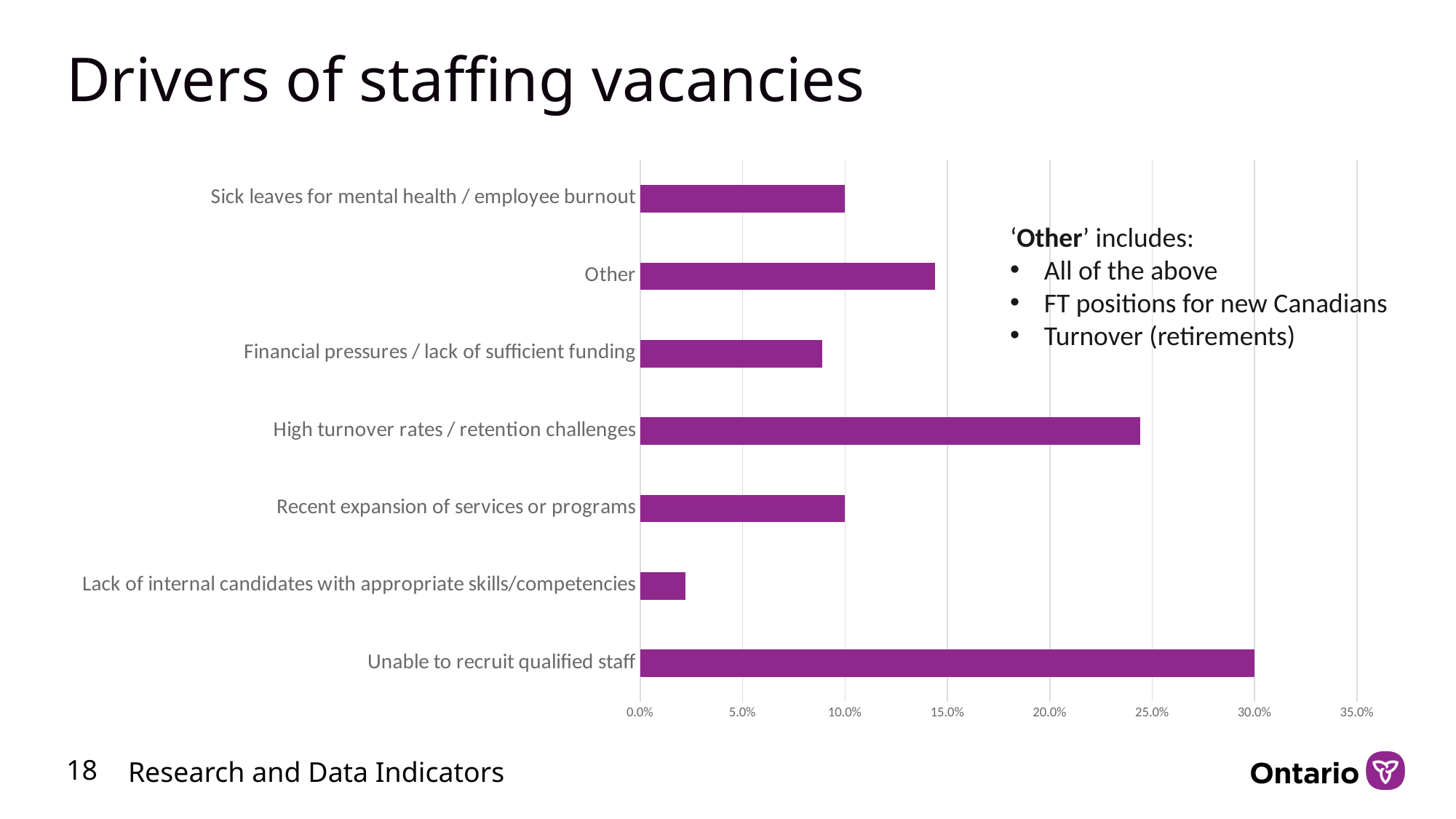
Which driver of staffing vacancies has the highest value? Unable to recruit qualified staff Which driver of staffing vacancies has the lowest value? Lack of internal candidates with appropriate skills/competencies What kind of chart is shown on the slide? bar chart Is the value for 'Other' greater or less than 10.0%? greater How many categories (drivers) are plotted in the chart? 7 Which is larger: the value for 'Other' or the value for 'Financial pressures / lack of sufficient funding'? Other Is the value for 'High turnover rates / retention challenges' greater or less than 20.0%? greater What is the value for 'Unable to recruit qualified staff'? 30.0% Which is larger: the value for 'High turnover rates / retention challenges' or the value for 'Recent expansion of services or programs'? High turnover rates / retention challenges Is the value for 'Financial pressures / lack of sufficient funding' greater or less than 10.0%? less What is the title of the slide containing the chart? Drivers of staffing vacancies